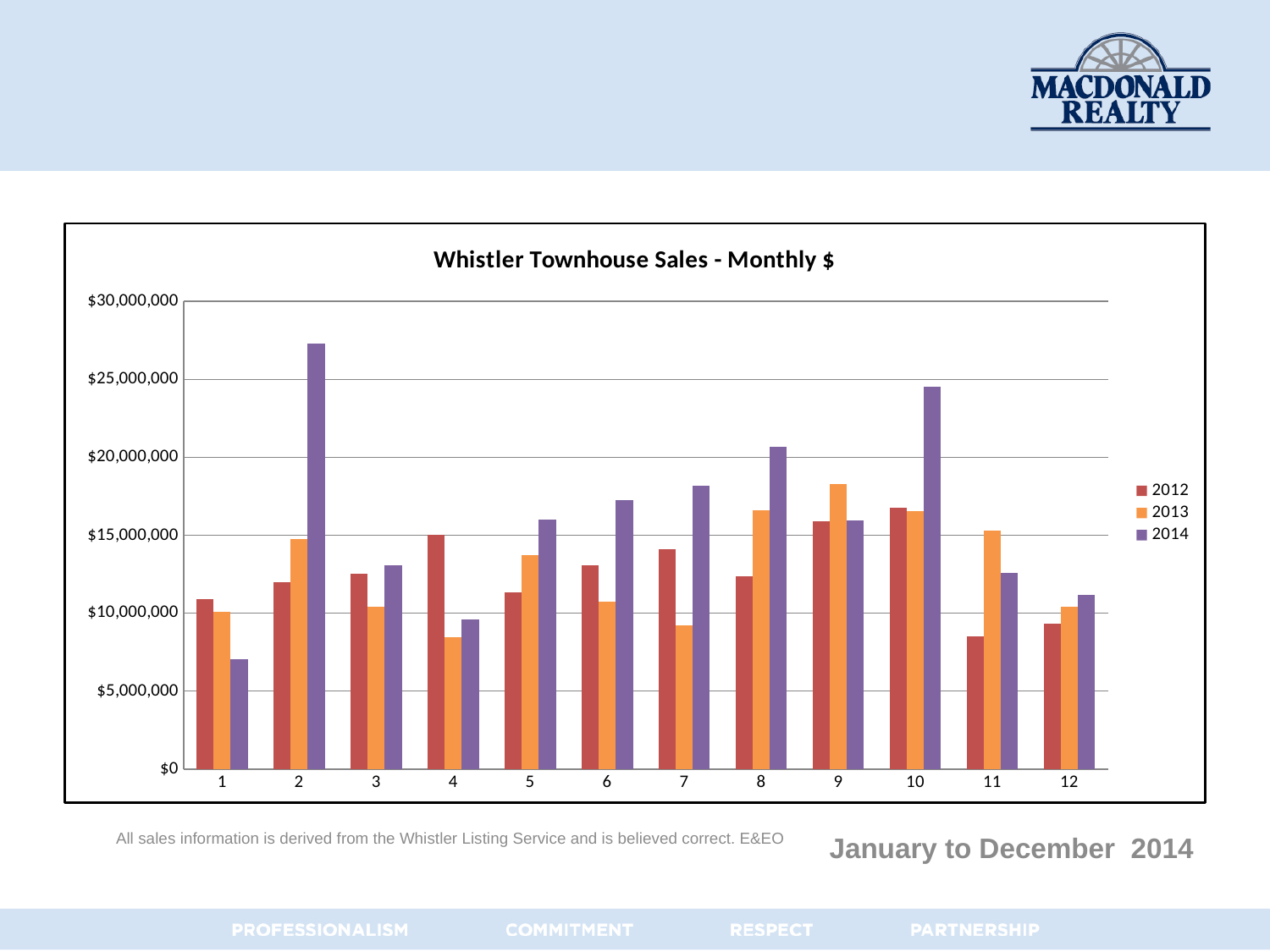
How many series does the legend list? 3 What kind of chart is shown on the slide? bar chart Is the 2013 value for month 4 greater or less than $10,000,000? less For month 8, which series has the larger value, 2012 or 2014? 2014 In which month is the 2013 value highest? 9 Is the 2014 value for month 10 greater or less than $20,000,000? greater In which month is the 2012 value lowest? 11 In which month is the 2014 value highest? 2 How many months (categories) are shown on the x axis? 12 What is the title of the chart? Whistler Townhouse Sales - Monthly $ In which month is the 2014 value lowest? 1 Is the 2014 value for month 2 greater or less than $25,000,000? greater